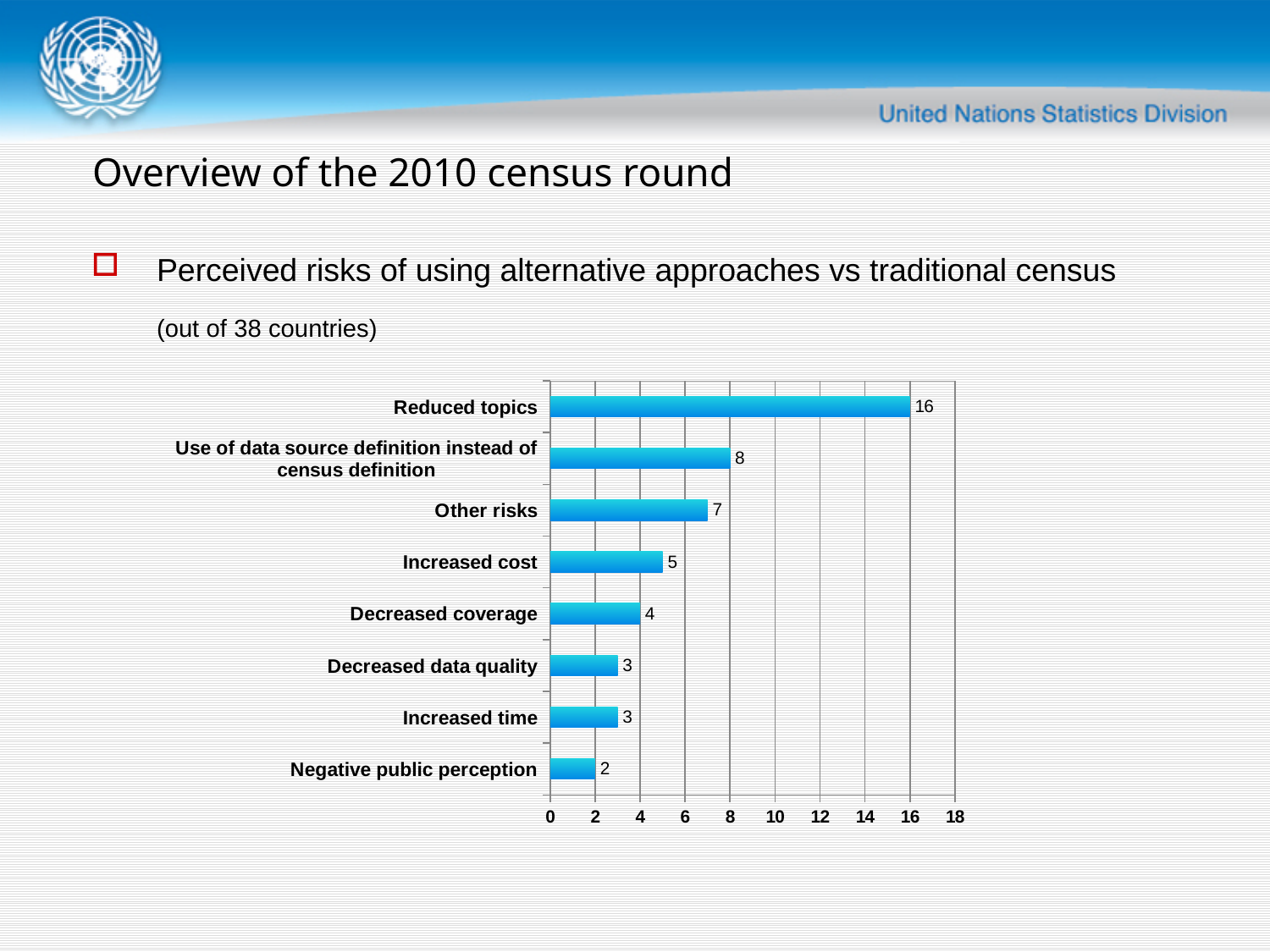
How many categories are shown in the chart? 8 What is the value for Reduced topics? 16 Which category has the highest value? Reduced topics Is the value for Other risks greater or less than 6? greater Which is larger, the value for Increased cost or the value for Decreased coverage? Increased cost What is the highest tick value shown on the horizontal axis? 18 What is the difference between the values for Reduced topics and Other risks? 9 What kind of chart is shown on the slide? bar chart What is the value for Negative public perception? 2 What is the value for Use of data source definition instead of census definition? 8 Which category has the lowest value? Negative public perception What is the value for Decreased coverage? 4